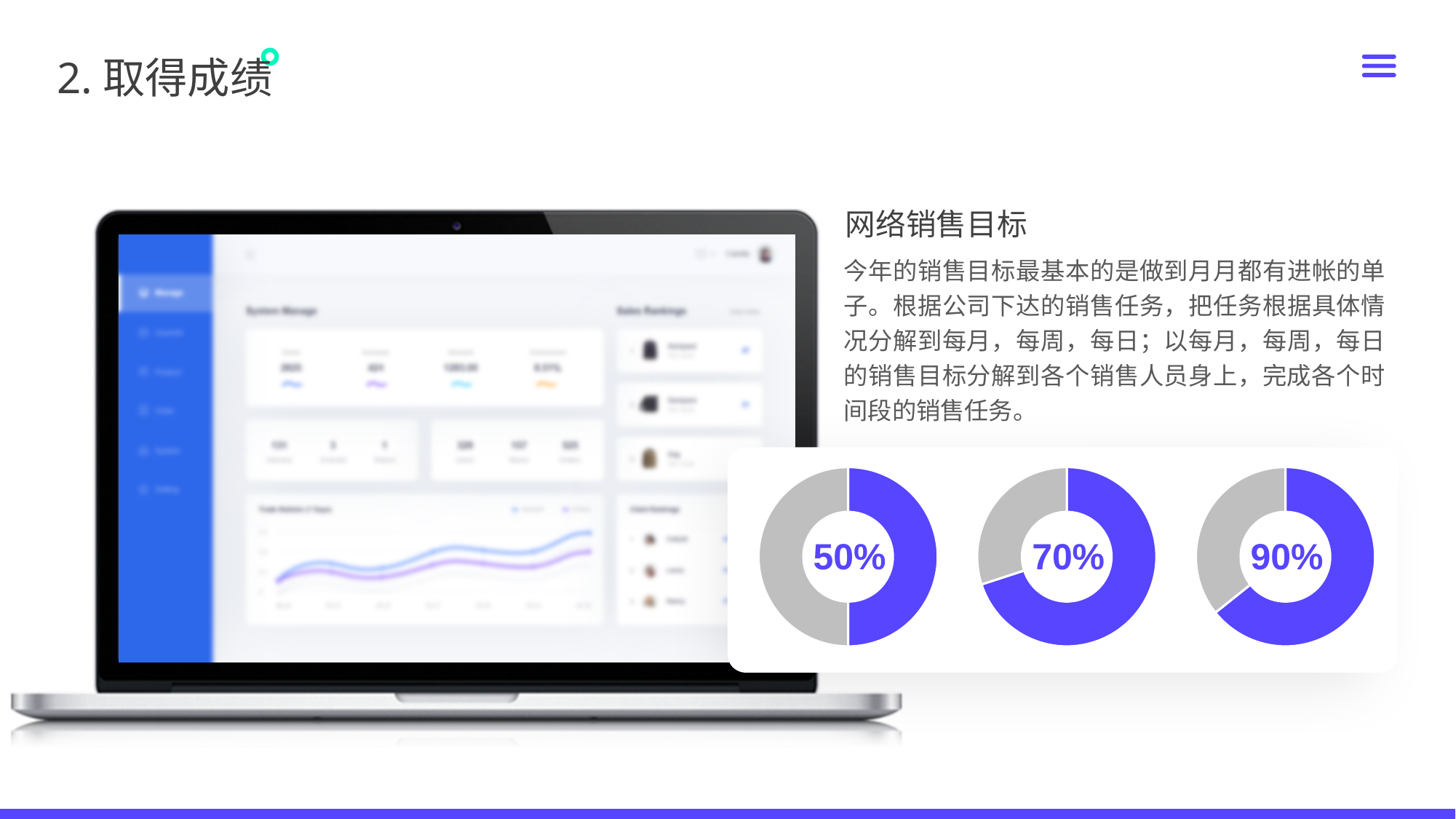
What is the difference between the percentage in the middle donut chart and the percentage in the left donut chart? 20% What kind of charts are the three charts in the white panel on the right of the slide? Donut (pie) charts What percentage is shown in the centre of the right donut chart? 90% What is the difference between the percentage in the right donut chart and the percentage in the left donut chart? 40% What colour is the filled (completed) portion of each donut chart? Blue/purple Which of the three donut charts shows the highest percentage? The right one (90%) Which of the three donut charts shows the lowest percentage? The left one (50%) Which shows a larger percentage, the middle donut chart or the right donut chart? The right donut chart What percentage is shown in the centre of the middle donut chart? 70% How many donut charts are shown on the slide? 3 Do the percentages in the donut charts increase or decrease from left to right? Increase What percentage is shown in the centre of the left donut chart? 50%